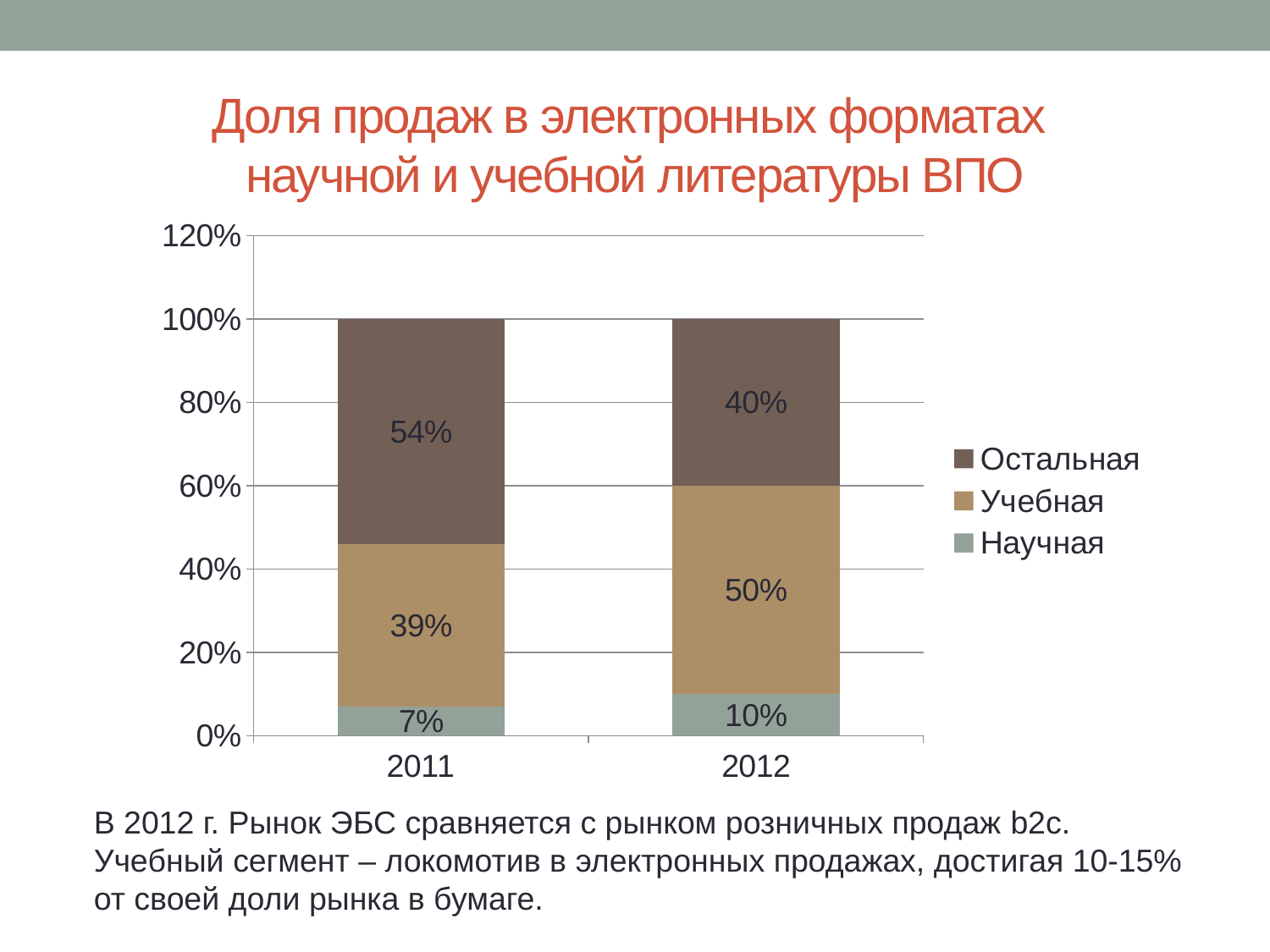
Which series has the smallest value in 2012? Научная Which is larger: Остальная in 2011 or Остальная in 2012? Остальная in 2011 Does the value for Научная rise or fall from 2011 to 2012? Rise What is the value for Научная in 2012? 10% How many categories are shown on the x axis? 2 What is the value for Остальная in 2012? 40% Which series has the largest value in 2011? Остальная What is the value for Учебная in 2011? 39% How many series does the legend list? 3 What is the difference between the Учебная values for 2012 and 2011? 11% What kind of chart is shown on the slide? Stacked bar chart What is the value for Научная in 2011? 7%